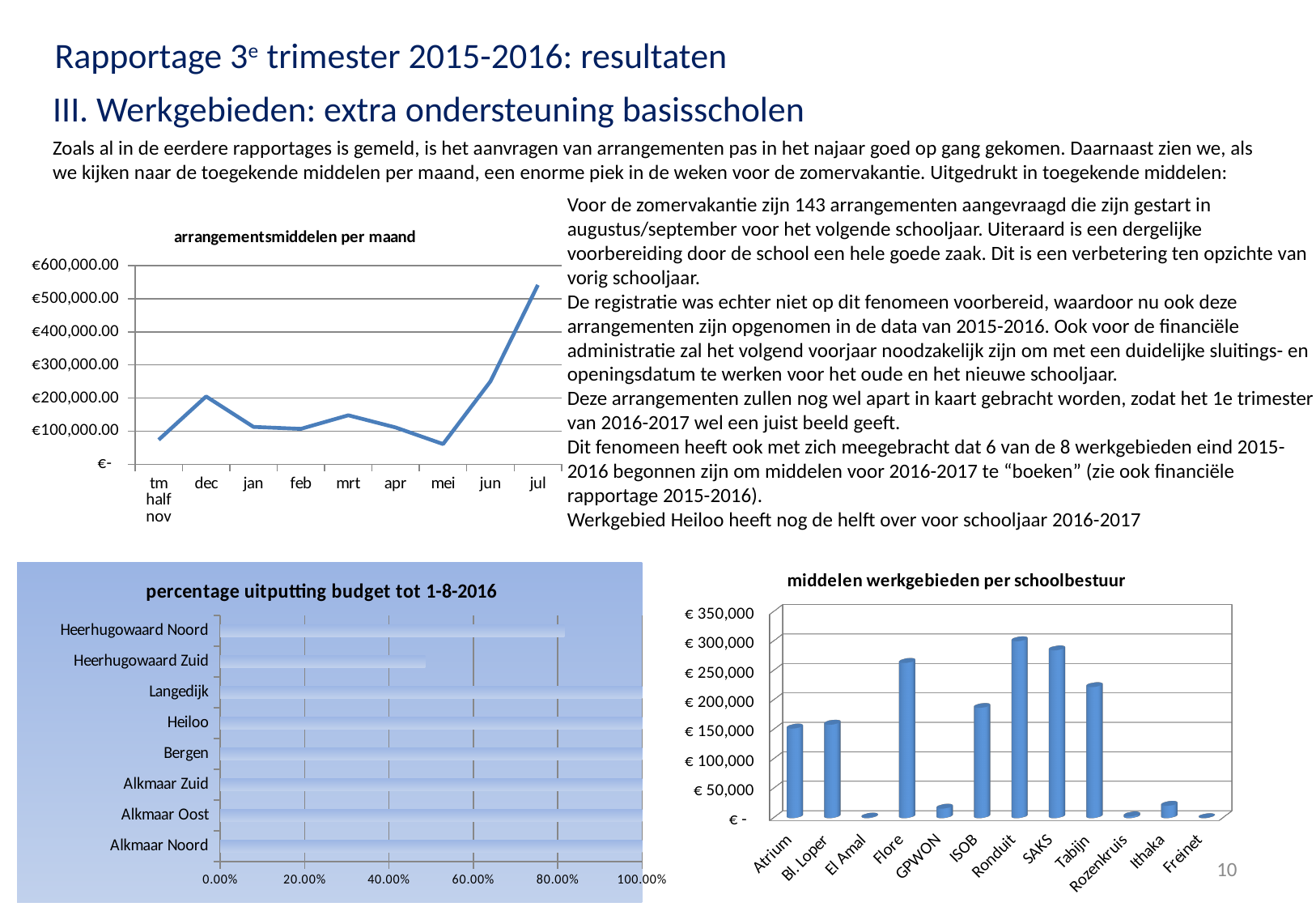
In the 'arrangementsmiddelen per maand' chart, which month has the lowest value? mei How many categories are shown in the 'middelen werkgebieden per schoolbestuur' chart? 12 In the 'middelen werkgebieden per schoolbestuur' chart, which is larger, Flore or Tabijn? Flore In the 'arrangementsmiddelen per maand' chart, which month has the highest value? jul In the 'arrangementsmiddelen per maand' chart, is the value for jul greater or less than €500,000.00? greater How many categories are shown in the 'percentage uitputting budget tot 1-8-2016' chart? 8 In the 'middelen werkgebieden per schoolbestuur' chart, which category has the highest value? Ronduit In the 'percentage uitputting budget tot 1-8-2016' chart, is the value for Heerhugowaard Zuid greater or less than 60.00%? less What kind of chart is the 'arrangementsmiddelen per maand' chart? line chart How many points are plotted along the x axis of the 'arrangementsmiddelen per maand' chart? 9 What kind of chart is the 'percentage uitputting budget tot 1-8-2016' chart? bar chart In the 'arrangementsmiddelen per maand' chart, do the values rise or fall between mei and jul? rise